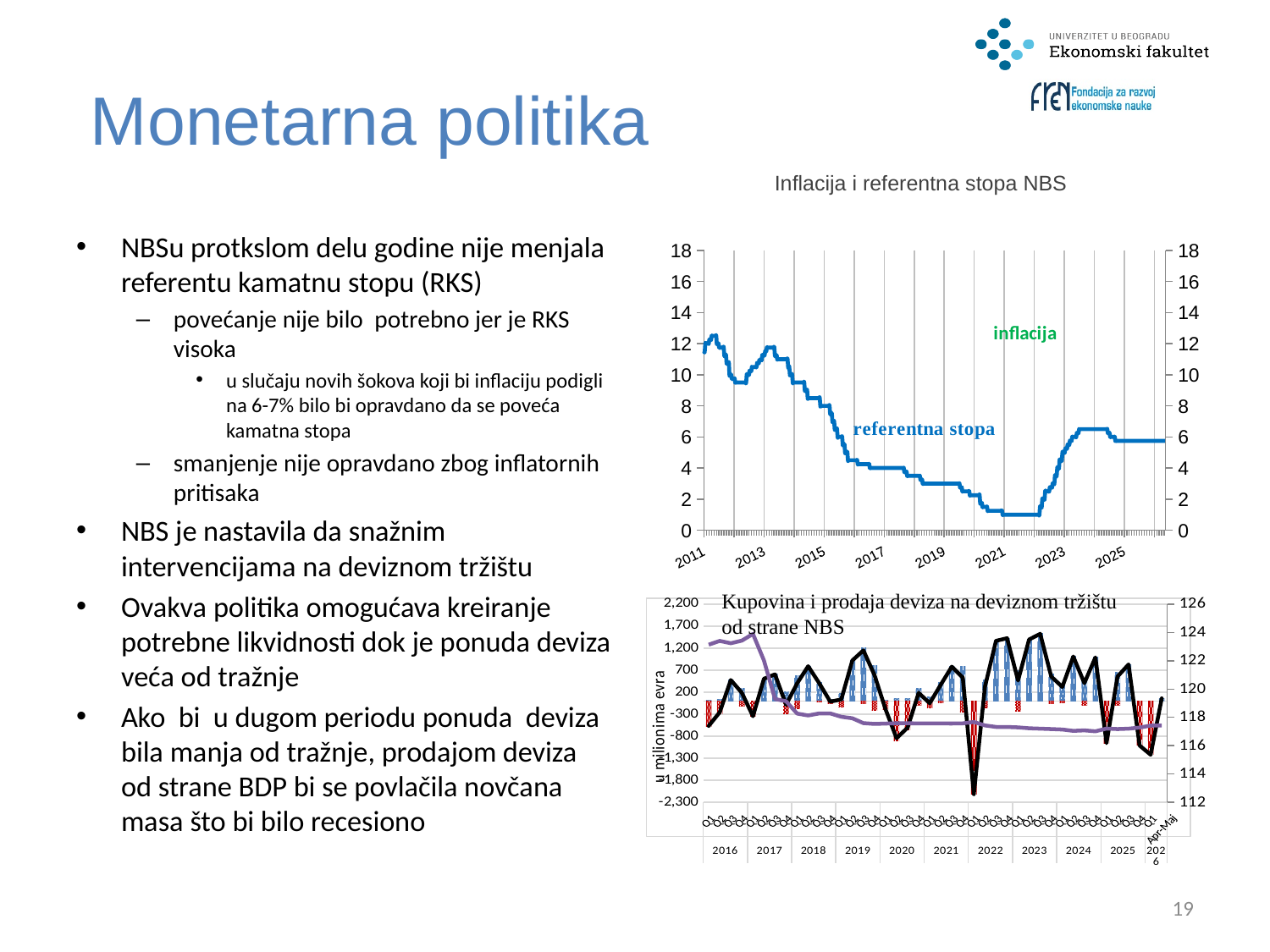
In the top chart 'Inflacija i referentna stopa NBS', what is the highest value shown on the left vertical axis? 18 What is the title of the top chart on the slide? Inflacija i referentna stopa NBS In the bottom chart 'Kupovina i prodaja deviza na deviznom tržištu od strane NBS', is the purple line at the end of the series in 2026 greater or less than 120 on the right axis? less In the bottom chart 'Kupovina i prodaja deviza na deviznom tržištu od strane NBS', what is the first year shown on the horizontal axis? 2016 In the bottom chart 'Kupovina i prodaja deviza na deviznom tržištu od strane NBS', what is the highest value shown on the right vertical axis? 126 In the top chart 'Inflacija i referentna stopa NBS', is the referentna stopa at the start of the series in 2011 greater or less than 10? greater In the bottom chart 'Kupovina i prodaja deviza na deviznom tržištu od strane NBS', is the lowest point of the black line in 2022 greater or less than -1,300? less In the top chart 'Inflacija i referentna stopa NBS', does the referentna stopa rise or fall between 2013 and 2021? fall What kind of chart is the top chart titled 'Inflacija i referentna stopa NBS'? line chart What is the label of the left vertical axis of the bottom chart 'Kupovina i prodaja deviza na deviznom tržištu od strane NBS'? u milionima evra